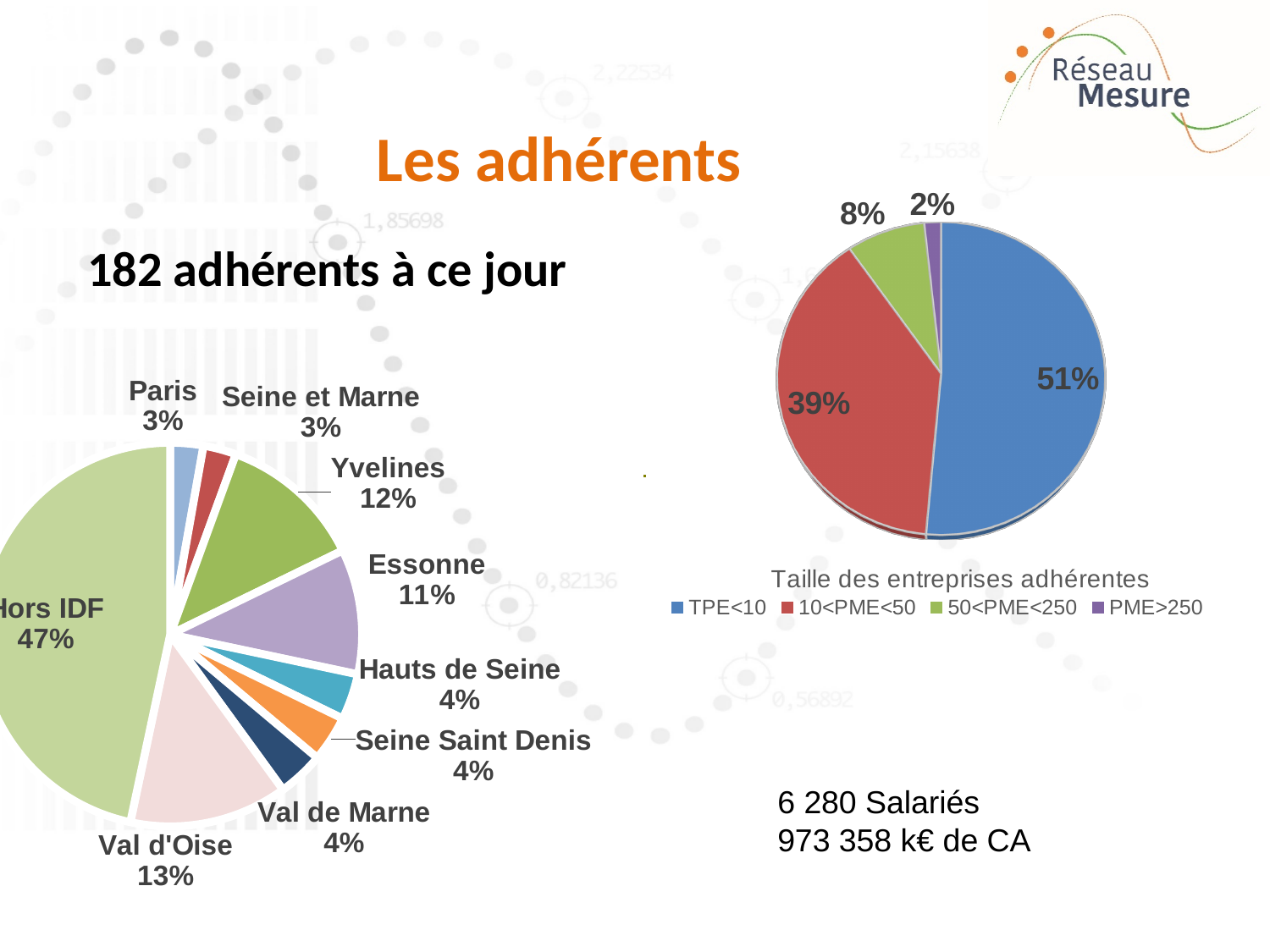
In the pie chart titled 'Taille des entreprises adhérentes', which category has the smallest share? PME>250 In the pie chart on the left of the slide, what share is shown for Yvelines? 12% In the pie chart titled 'Taille des entreprises adhérentes', what share is shown for TPE<10? 51% In the pie chart on the left of the slide, which category has the largest share? Hors IDF What kind of chart is used on the right of the slide for 'Taille des entreprises adhérentes'? Pie chart In the pie chart on the left of the slide, how many categories are shown? 9 In the pie chart titled 'Taille des entreprises adhérentes', what share is shown for 10<PME<50? 39% In the pie chart on the left of the slide, which is larger, the share for Essonne or the share for Hauts de Seine? Essonne In the pie chart on the left of the slide, what is the difference between the shares for Val d'Oise and Paris? 10% In the pie chart on the left of the slide, what share is shown for Val d'Oise? 13% In the pie chart titled 'Taille des entreprises adhérentes', what is the difference between the shares for TPE<10 and 10<PME<50? 12% In the pie chart titled 'Taille des entreprises adhérentes', how many categories does the legend list? 4